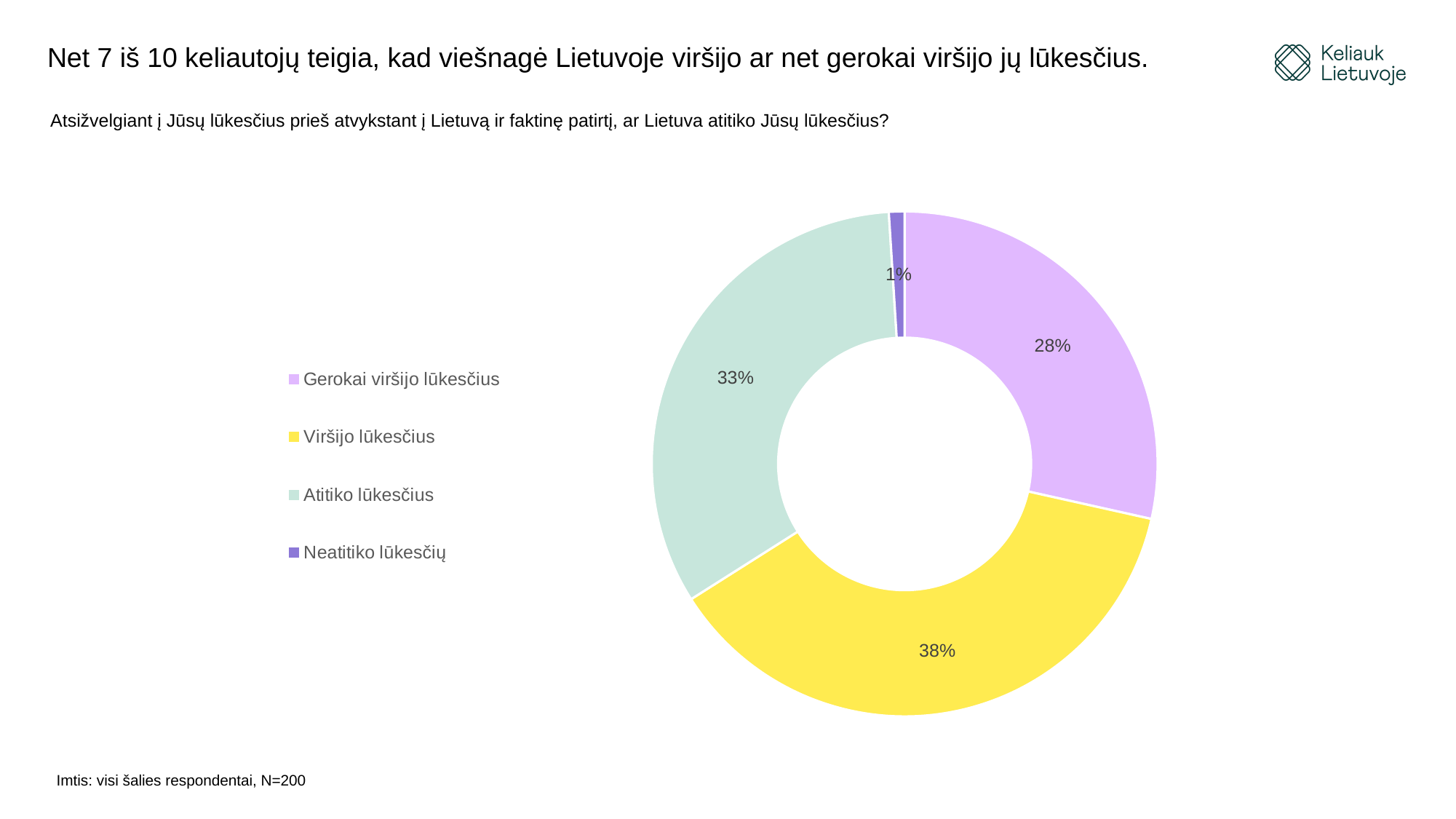
What is the combined share of "Gerokai viršijo lūkesčius" and "Viršijo lūkesčius"? 66% Which response category has the smallest share of the chart? Neatitiko lūkesčių Which response category has the largest share of the chart? Viršijo lūkesčius What percentage of respondents answered "Atitiko lūkesčius"? 33% What is the difference in percentage points between "Viršijo lūkesčius" and "Gerokai viršijo lūkesčius"? 10 percentage points How many response categories are shown in the chart? 4 Which is larger: the share for "Atitiko lūkesčius" or the share for "Gerokai viršijo lūkesčius"? Atitiko lūkesčius What percentage of respondents answered "Neatitiko lūkesčių"? 1% What kind of chart is shown on the slide? Pie chart (doughnut) What percentage of respondents answered "Gerokai viršijo lūkesčius"? 28% What colour represents "Atitiko lūkesčius" in the chart? Light green (mint) What percentage of respondents answered "Viršijo lūkesčius"? 38%